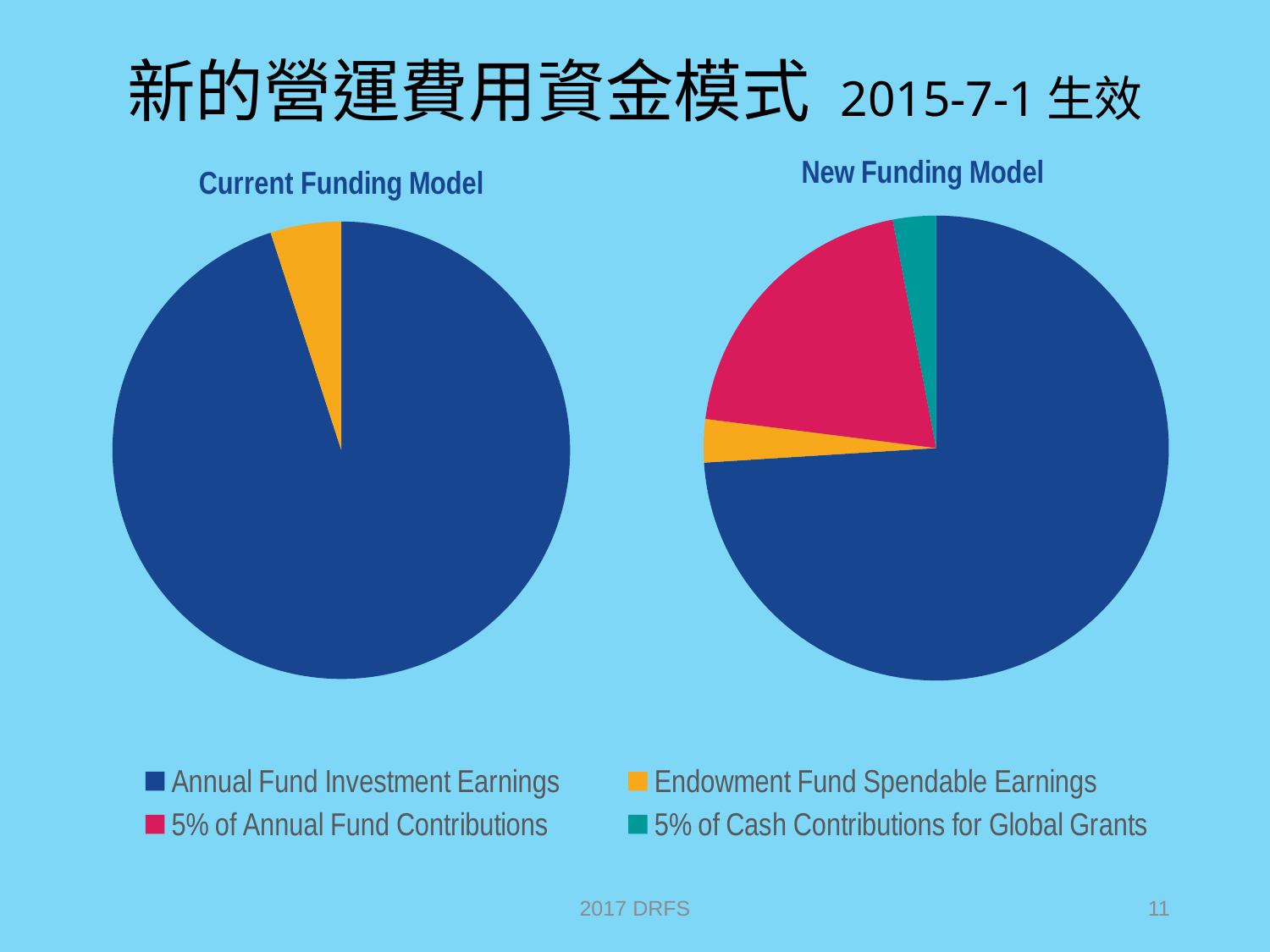
Which colour represents 5% of Cash Contributions for Global Grants in the legend? teal What kind of chart is the New Funding Model chart? pie chart How many slices does the Current Funding Model pie chart have? 2 In the Current Funding Model chart, which category has the smallest slice? Endowment Fund Spendable Earnings What is the title of the pie chart on the left of the slide? Current Funding Model In the Current Funding Model chart, which category has the largest slice? Annual Fund Investment Earnings How many entries does the shared legend list? 4 How many slices does the New Funding Model pie chart have? 4 In the New Funding Model chart, which category has the largest slice? Annual Fund Investment Earnings What kind of chart is the Current Funding Model chart? pie chart In the New Funding Model chart, which slice is larger: 5% of Annual Fund Contributions or Endowment Fund Spendable Earnings? 5% of Annual Fund Contributions